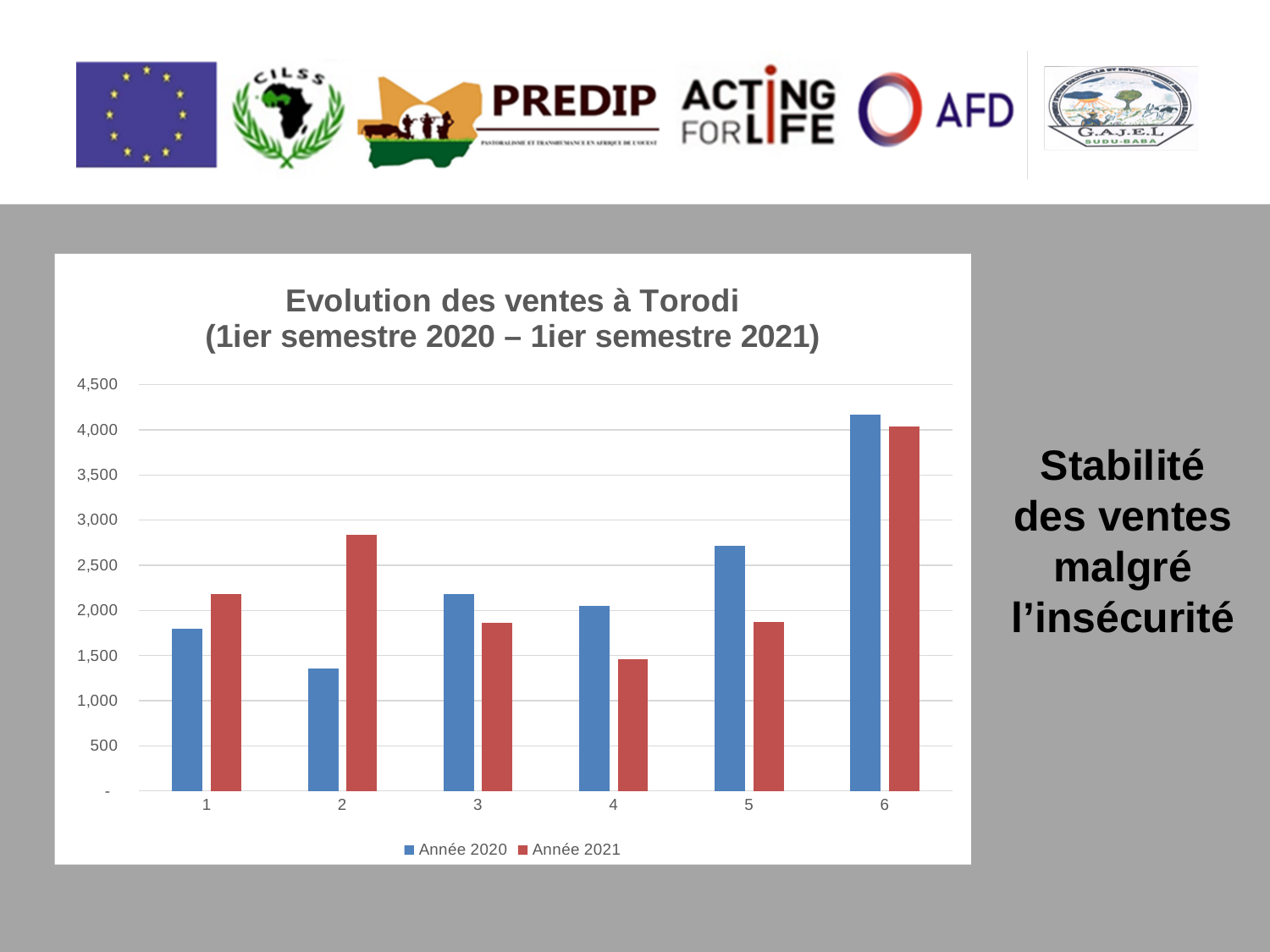
Which category has the highest value for Année 2020? 6 How many categories are shown on the x axis? 6 How many series does the legend list? 2 Which category has the lowest value for Année 2020? 2 For category 5, which series has the larger value, Année 2020 or Année 2021? Année 2020 What are the two series named in the legend? Année 2020 and Année 2021 Is the Année 2020 value for category 6 greater or less than 4,000? greater Is the Année 2020 value for category 2 greater or less than 1,500? less Is the Année 2021 value for category 2 greater or less than 2,500? greater For category 2, which series has the larger value, Année 2020 or Année 2021? Année 2021 What kind of chart is shown on the slide? bar chart Which category has the lowest value for Année 2021? 4